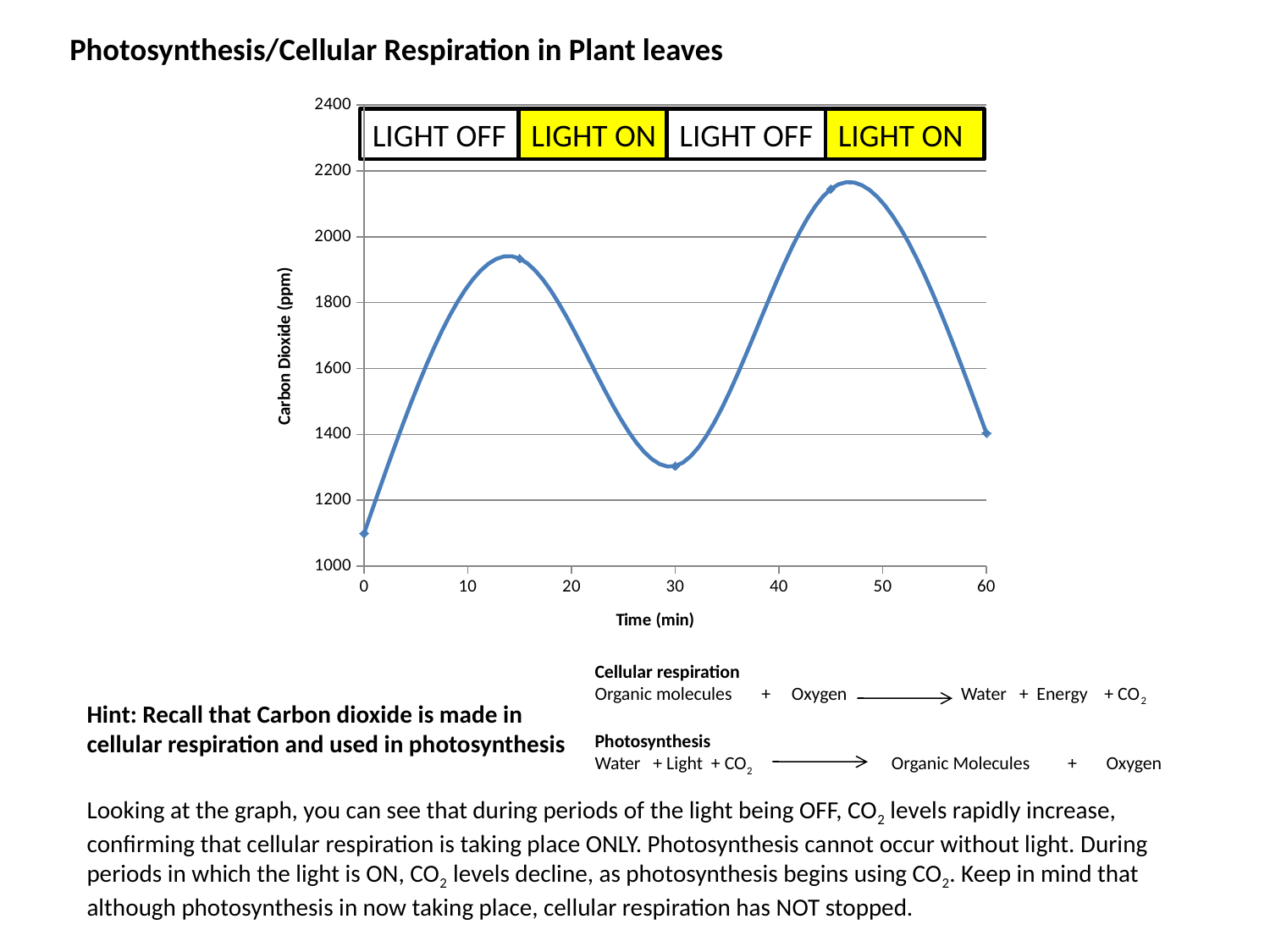
What is the label of the y axis? Carbon Dioxide (ppm) What is the label of the x axis? Time (min) Which has the higher carbon dioxide level, 15 min or 45 min? 45 min How many data points are plotted on the line? 5 Is the carbon dioxide value at 15 min greater or less than 1800? greater Is the carbon dioxide value at 30 min greater or less than 1400? less Is the carbon dioxide value at 45 min greater or less than 2000? greater At which time is the carbon dioxide level lowest? 0 min What kind of chart is shown on the slide? line chart Does the carbon dioxide level rise or fall between 15 min and 30 min? fall At which time is the carbon dioxide level highest? 45 min